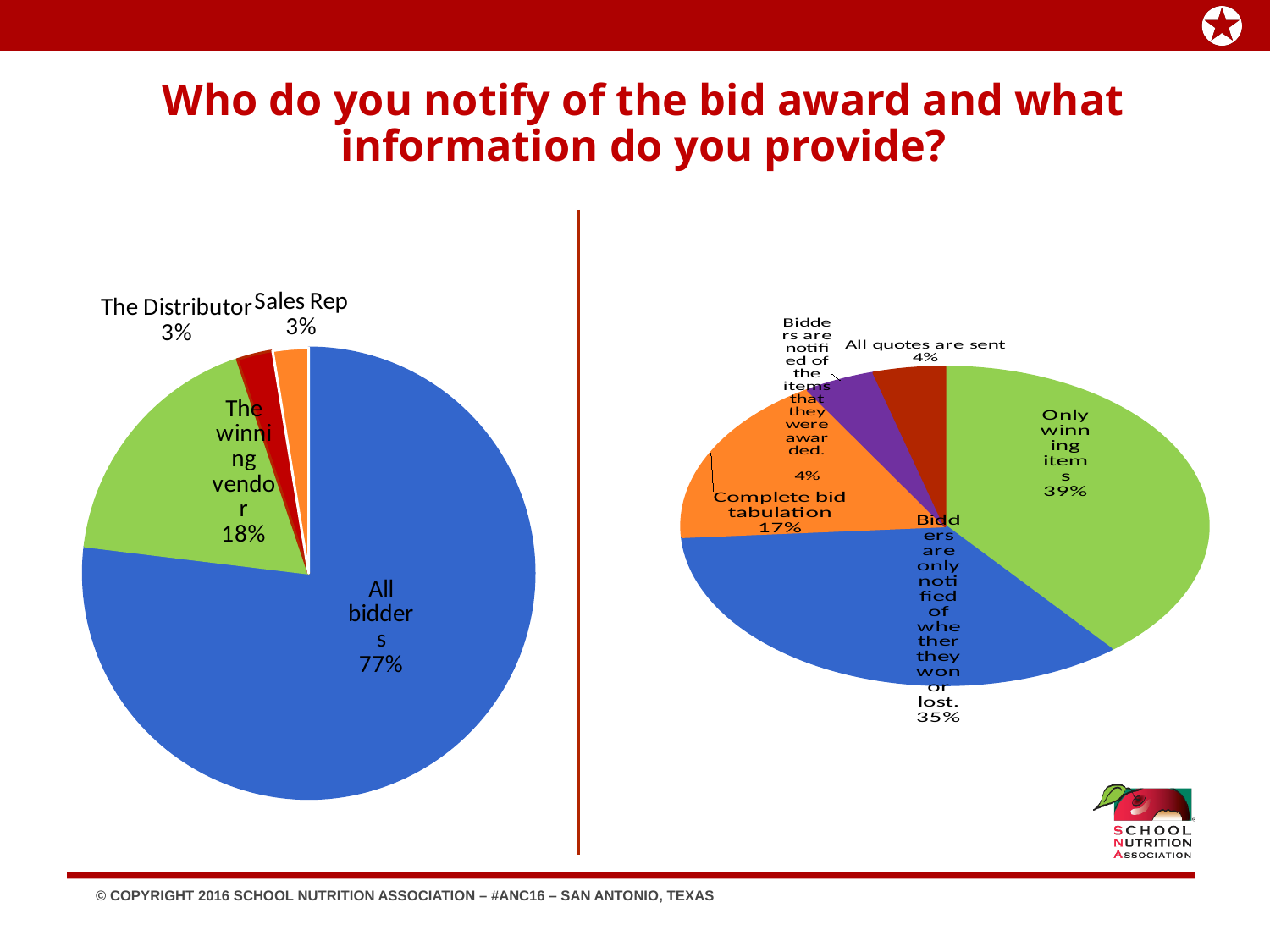
In the left pie chart, what share is labelled for The Distributor? 3% In the right pie chart, what share is labelled for Only winning items? 39% In the left pie chart, what share is labelled for The winning vendor? 18% In the left pie chart, how many slices are there? 4 What kind of chart is shown on the right side of the slide? Pie chart In the left pie chart, what is the difference between the All bidders share and The winning vendor share? 59% In the right pie chart, which is larger: Only winning items or Complete bid tabulation? Only winning items In the left pie chart, what share is labelled for All bidders? 77% In the left pie chart, which category has the largest slice? All bidders In the right pie chart, which category has the largest slice? Only winning items In the right pie chart, how many slices are there? 5 In the right pie chart, what share is labelled for Complete bid tabulation? 17%